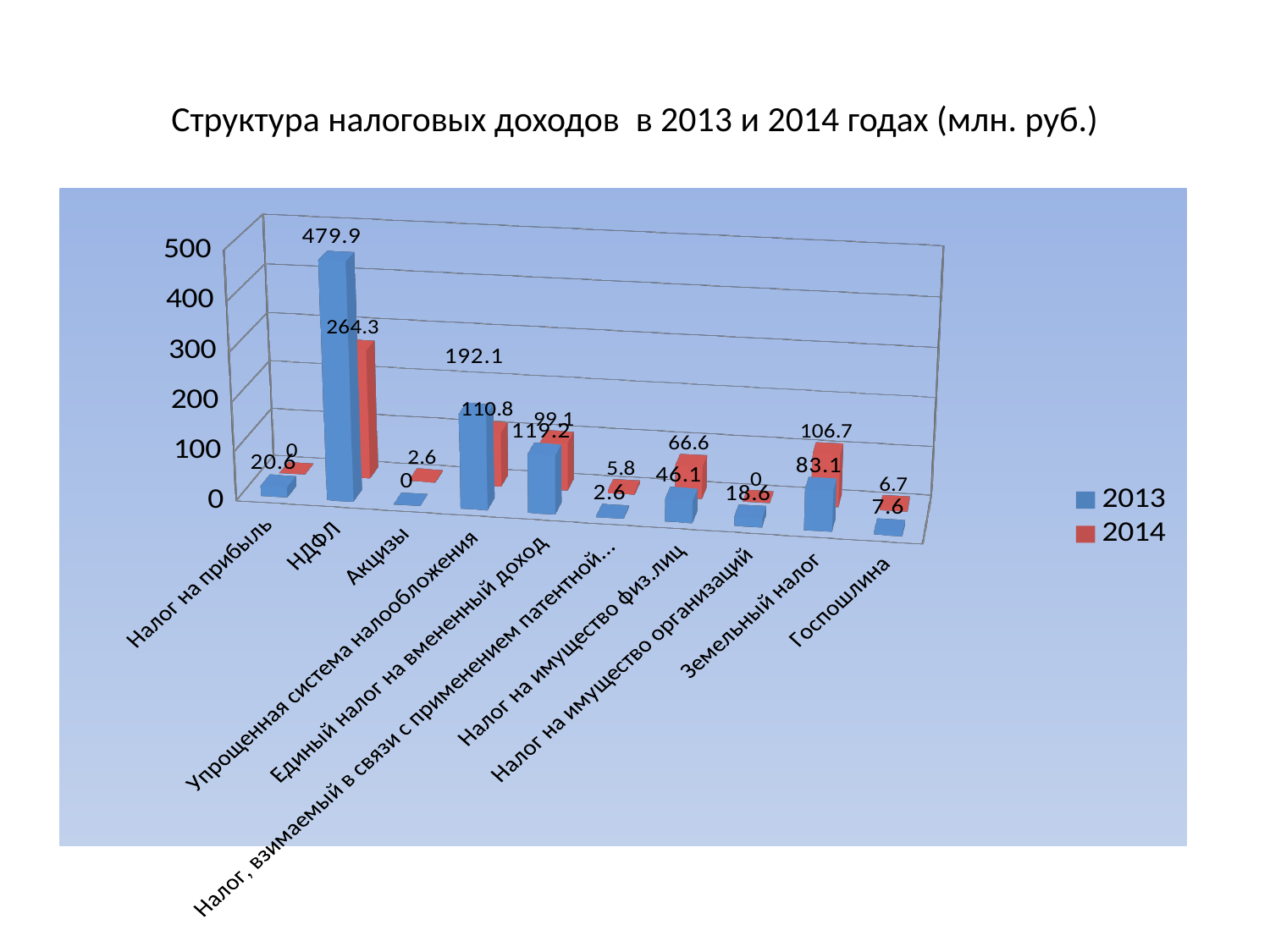
What kind of chart is shown on the slide? Bar chart Which is larger for Земельный налог, the 2013 value or the 2014 value? 2014 How many series does the legend list? 2 What is the difference between the 2013 and 2014 values for НДФЛ? 215.6 What is the 2014 value for Земельный налог? 106.7 What is the 2013 value for НДФЛ? 479.9 Which category has the lowest 2013 value? Акцизы What is the 2013 value for Упрощенная система налообложения? 192.1 What is the 2014 value for Налог на имущество физ.лиц? 66.6 Which category has the highest 2013 value? НДФЛ Which colour represents the 2014 series in the legend? Red How many categories are shown on the x axis? 10